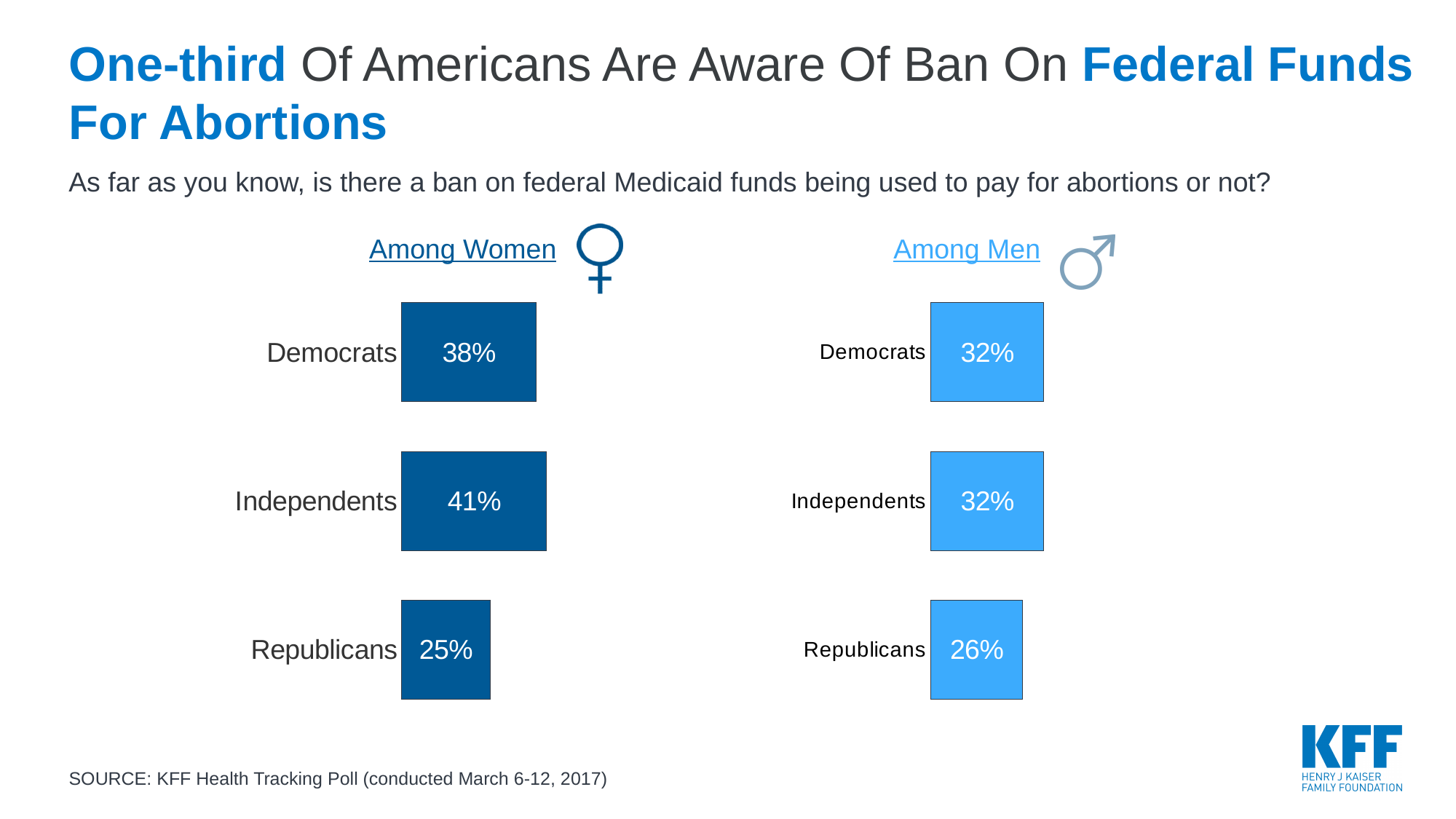
In the Among Women chart, what percentage of Democrats are aware of the ban? 38% What kind of chart is the Among Women chart? Bar chart In the Among Men chart, what is the value for Republicans? 26% In the Among Women chart, which group has the lowest value? Republicans In the Among Men chart, which group has the lowest value? Republicans In the Among Women chart, what is the difference between the values for Independents and Republicans? 16 percentage points In the Among Women chart, what is the value for Independents? 41% Which is larger: the value for Democrats among women or the value for Democrats among men? Democrats among women What is the difference between the Republicans value among men and the Republicans value among women? 1 percentage point In the Among Women chart, which group has the highest value? Independents How many groups are shown in the Among Men chart? 3 In the Among Men chart, what is the value for Democrats? 32%